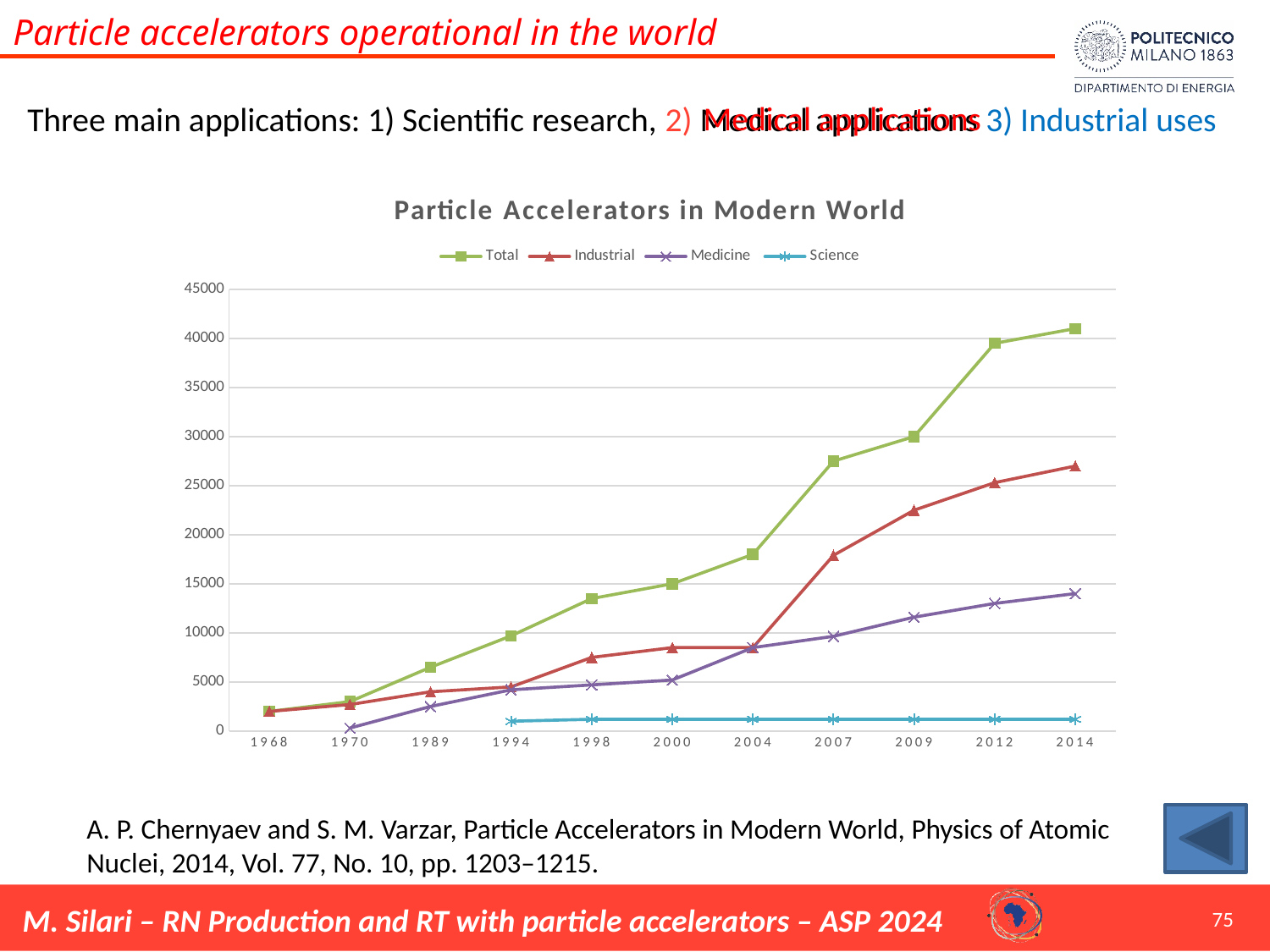
Is the value for Science in 2014 greater or less than 5000? less What is the title of the chart? Particle Accelerators in Modern World Does the Total series rise or fall from 1968 to 2014? rise Is the value for Medicine in 2014 greater or less than 15000? less Is the value for Industrial in 2014 greater or less than 25000? greater In which year does the Total series reach its highest value? 2014 How many years are shown along the x axis of the chart? 11 In 2014, which series has the larger value, Industrial or Medicine? Industrial How many series does the chart legend list? 4 In which year is the Total series at its lowest value? 1968 What kind of chart is shown on the slide? line chart